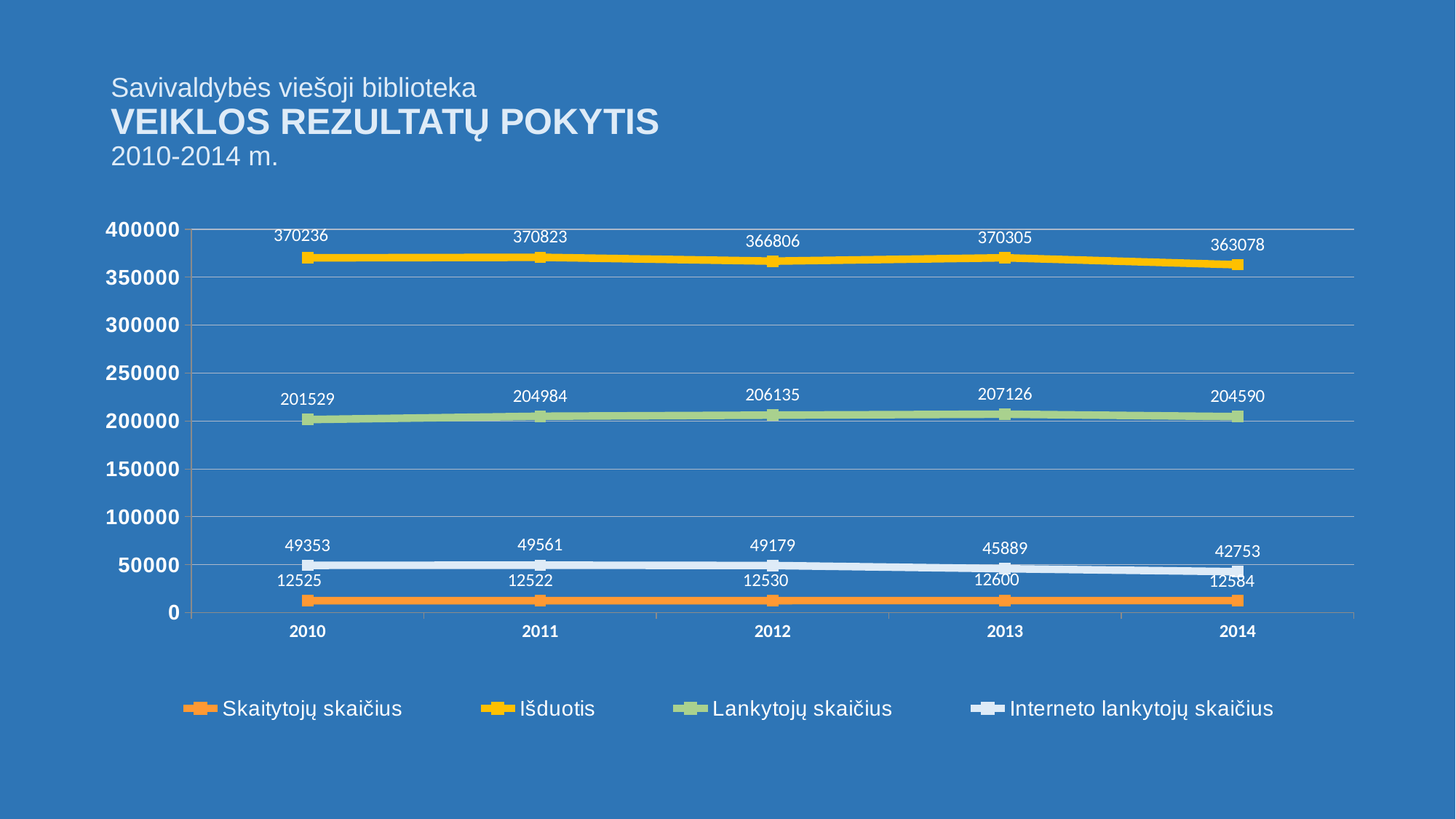
What kind of chart is shown on the slide? line chart In which year is Interneto lankytojų skaičius lowest? 2014 What is the value of Skaitytojų skaičius in 2010? 12525 What is the value of Lankytojų skaičius in 2013? 207126 How many series does the legend list? 4 What is the value of Išduotis in 2012? 366806 What is the difference between Interneto lankytojų skaičius in 2010 and in 2014? 6600 In which year is Išduotis highest? 2011 Does Interneto lankytojų skaičius rise or fall from 2011 to 2014? fall Which is larger for Lankytojų skaičius: the value in 2011 or in 2014? 2011 How many years are shown on the x axis? 5 What is the value of Interneto lankytojų skaičius in 2014? 42753